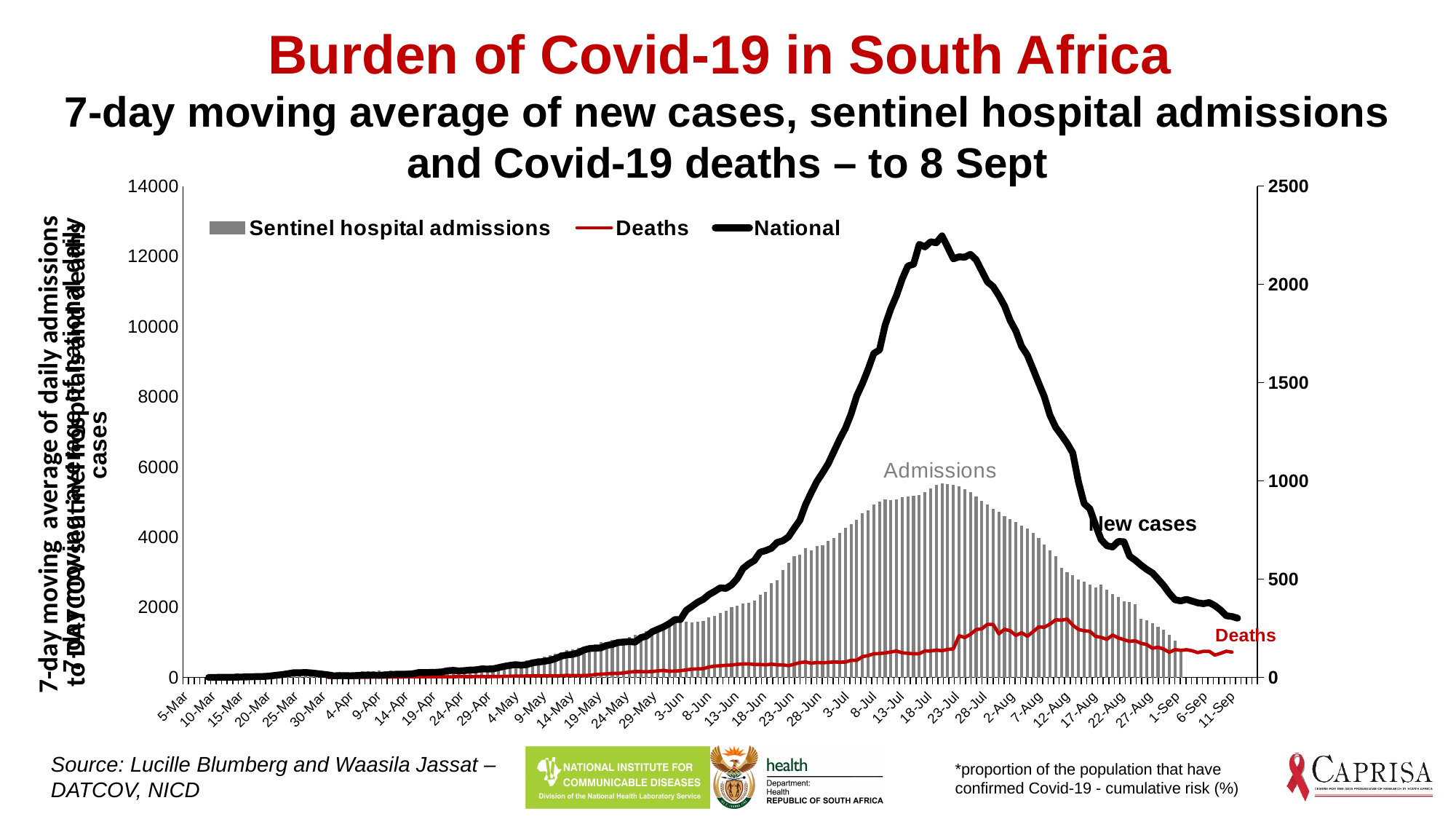
Which series in the legend is drawn as grey bars? Sentinel hospital admissions What is the maximum value shown on the right-hand axis? 2500 Do the Sentinel hospital admissions bars rise or fall between 28-Jul and 1-Sep? Fall Is the peak of the Deaths line greater or less than 500 on the right axis? less Which series reaches the highest point on the chart? National Is the peak value of the National new cases line greater or less than 10000 on the left axis? greater What kind of chart is shown on the slide? Combined bar and line chart Which series in the legend is drawn as a red line? Deaths How many series does the chart legend list? 3 Does the National new cases line rise or fall between 23-Jul and 11-Sep? Fall Does the National new cases line rise or fall between 3-Jun and 18-Jul? Rise Is the peak of the Sentinel hospital admissions bars greater or less than 8000 on the left axis? less